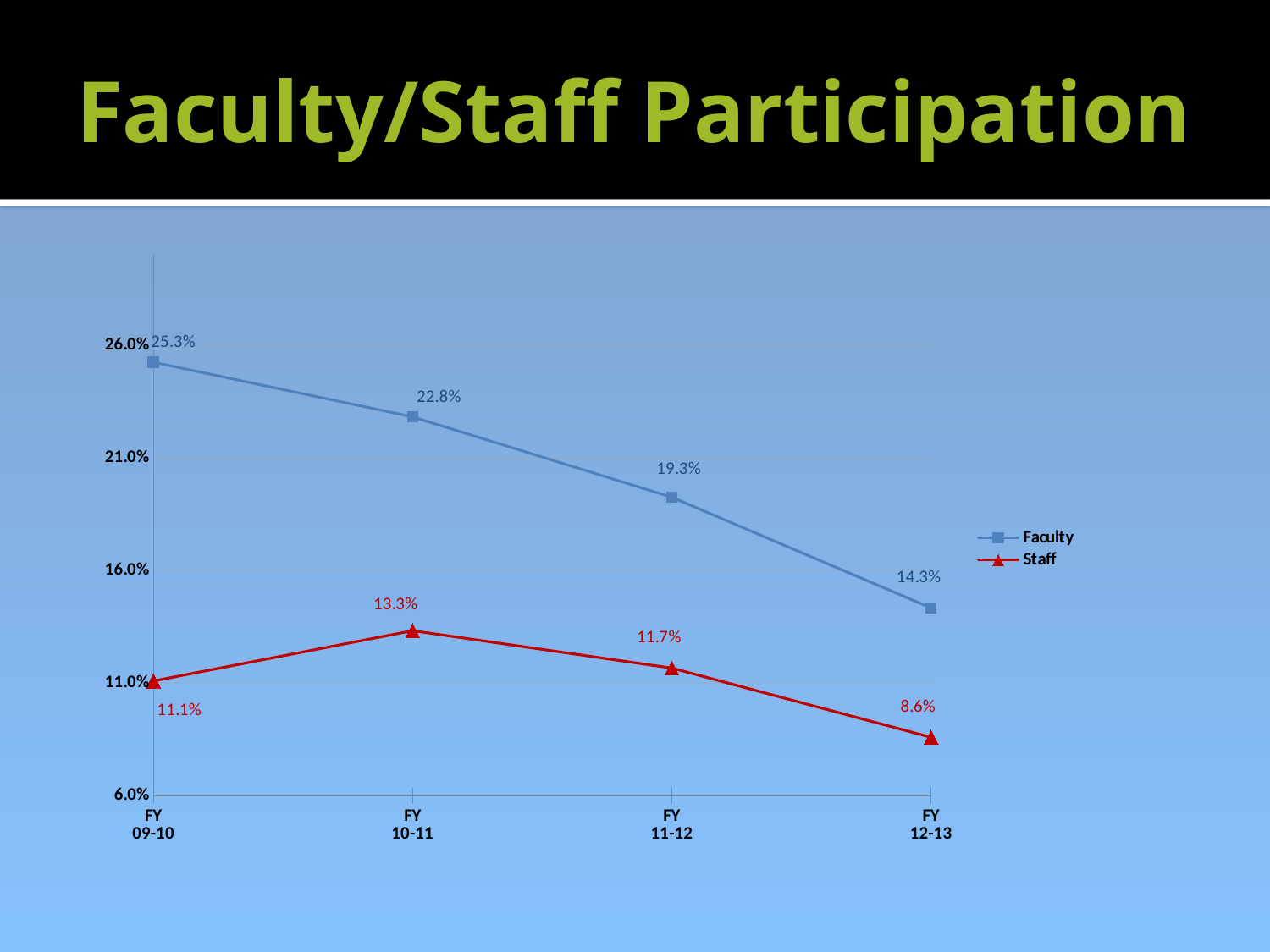
What kind of chart is shown on the slide? Line chart What is the Staff participation value for FY 12-13? 8.6% What is the Staff participation value for FY 10-11? 13.3% What is the difference between Faculty and Staff participation in FY 11-12? 7.6% How many series does the legend list? 2 In which fiscal year is Staff participation highest? FY 10-11 In which fiscal year is Faculty participation lowest? FY 12-13 Which is larger in FY 10-11, Faculty participation or Staff participation? Faculty What is the Faculty participation value for FY 12-13? 14.3% Does Faculty participation rise or fall from FY 09-10 to FY 12-13? Fall What is the Faculty participation value for FY 09-10? 25.3% How many fiscal years are plotted on the x axis? 4